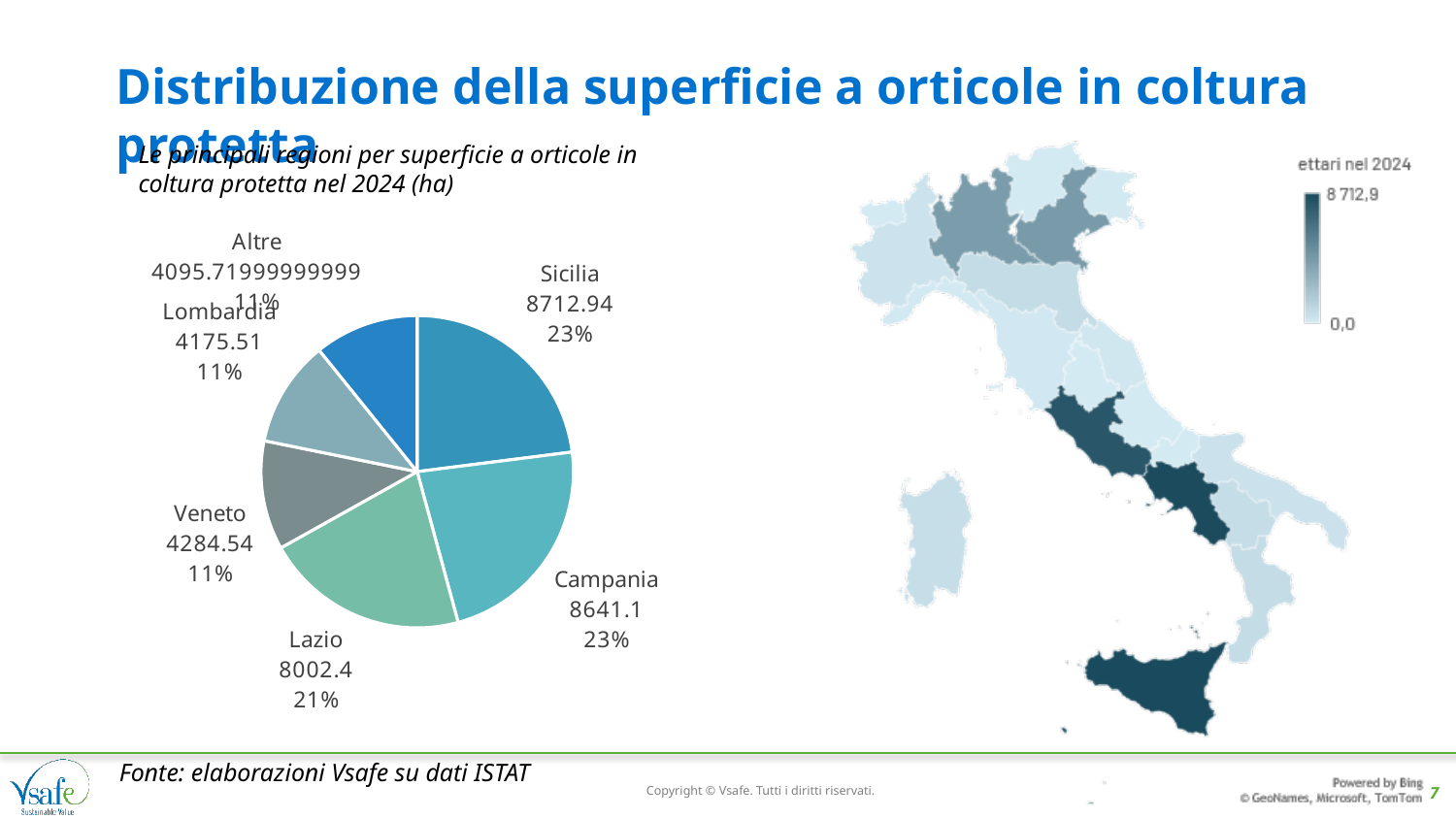
In the pie chart, what is the value shown for Sicilia? 8712.94 In the pie chart, what share of the total does Lazio represent? 21% In the pie chart, what is the value shown for Veneto? 4284.54 In the pie chart, which slice has the smallest value? Altre In the pie chart, what is the value shown for Campania? 8641.1 What kind of chart is shown on the left of the slide? Pie chart In the pie chart, which region has the largest value? Sicilia In the pie chart, what is the value shown for Lazio? 8002.4 In the pie chart, what is the value shown for Lombardia? 4175.51 In the pie chart, which is larger, the value for Lazio or the value for Veneto? Lazio How many slices does the pie chart have? 6 In the pie chart, what is the difference between the values for Sicilia and Campania? 71.84